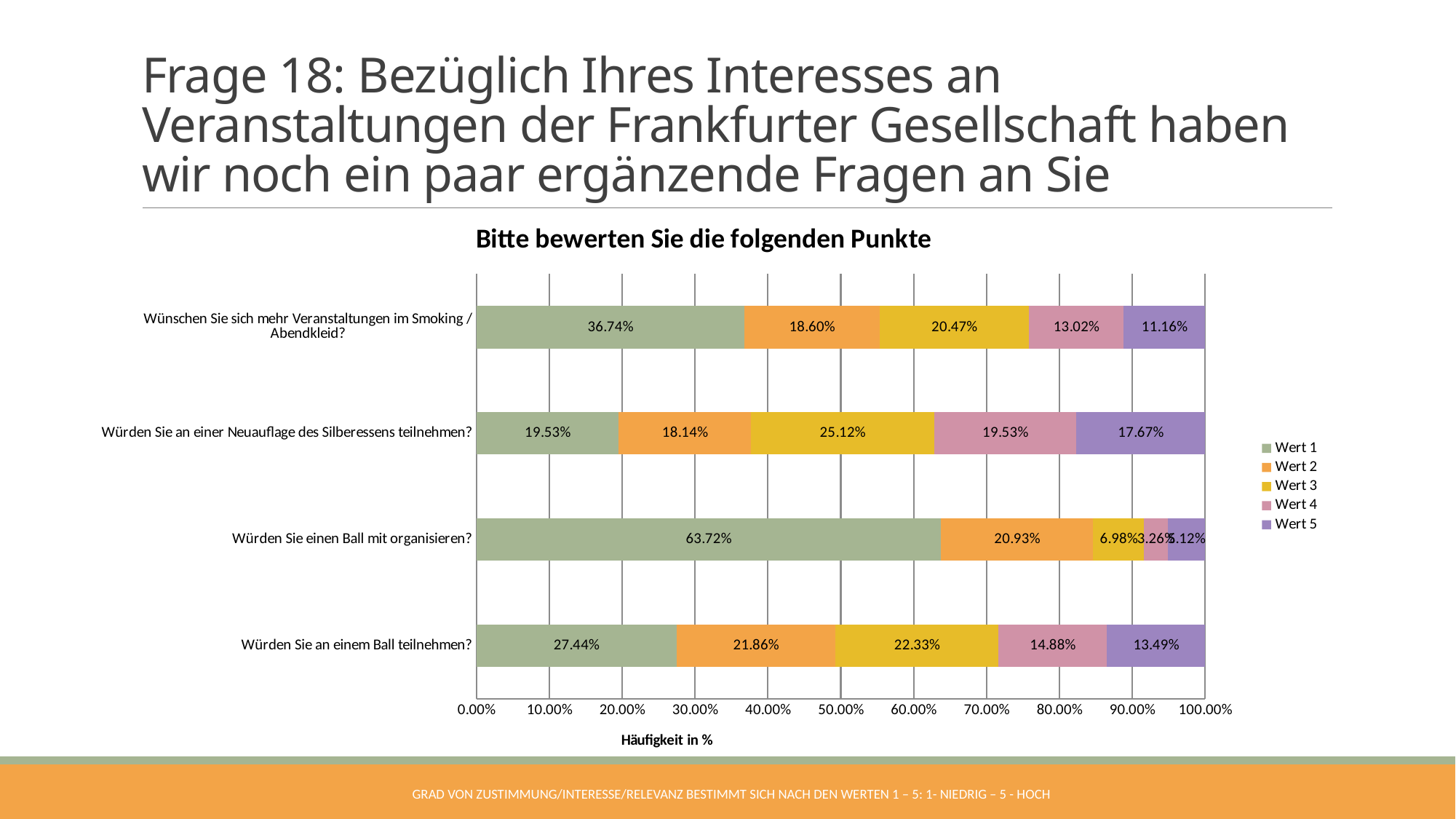
What is the difference between the Wert 1 value for "Wünschen Sie sich mehr Veranstaltungen im Smoking / Abendkleid?" and the Wert 1 value for "Würden Sie an einem Ball teilnehmen?"? 9.30% What is the Wert 4 value for "Würden Sie an einem Ball teilnehmen?"? 14.88% What is the Wert 1 value for "Würden Sie einen Ball mit organisieren?"? 63.72% Which category has the lowest Wert 1 value? Würden Sie an einer Neuauflage des Silberessens teilnehmen? What is the Wert 5 value for "Wünschen Sie sich mehr Veranstaltungen im Smoking / Abendkleid?"? 11.16% What is the title of the x axis? Häufigkeit in % Which category has the highest Wert 1 value? Würden Sie einen Ball mit organisieren? What is the Wert 3 value for "Würden Sie an einer Neuauflage des Silberessens teilnehmen?"? 25.12% Which has the larger Wert 2 value: "Würden Sie an einem Ball teilnehmen?" or "Wünschen Sie sich mehr Veranstaltungen im Smoking / Abendkleid?"? Würden Sie an einem Ball teilnehmen? How many series does the legend list? 5 How many categories (questions) are shown in the chart? 4 What kind of chart is shown on the slide? Stacked bar chart